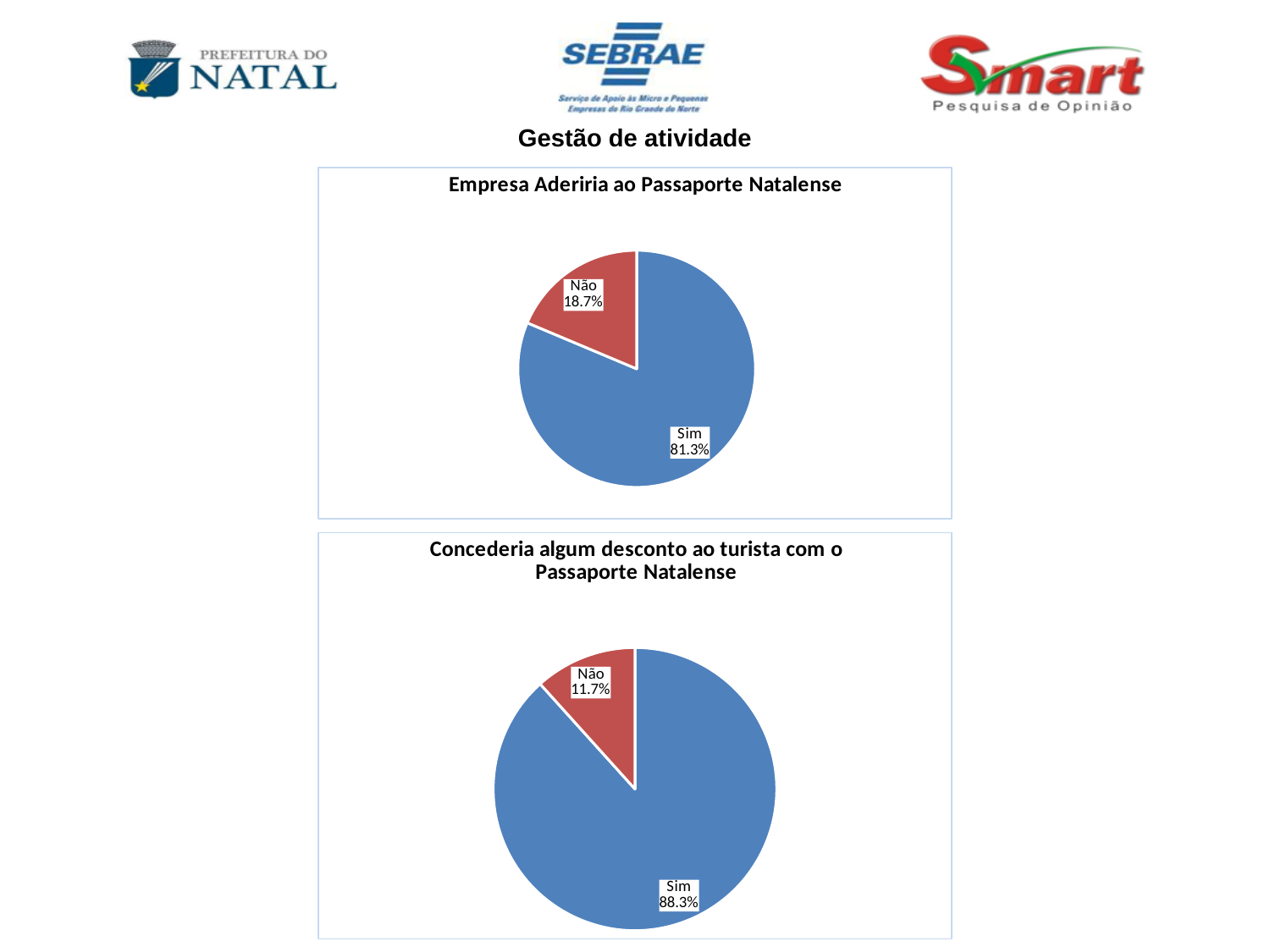
Which chart has the larger Não share, the top chart or the bottom chart? the top chart In the chart titled "Empresa Aderiria ao Passaporte Natalense", what percentage answered Sim? 81.3% In the top chart, what is the difference in percentage points between Sim and Não? 62.6 In the top chart, which response has the largest share? Sim In the bottom chart, which response has the smallest share? Não How many slices does the top chart have? 2 In the chart titled "Concederia algum desconto ao turista com o Passaporte Natalense", what percentage answered Sim? 88.3% In the bottom chart, what is the difference in percentage points between Sim and Não? 76.6 In the chart titled "Concederia algum desconto ao turista com o Passaporte Natalense", what percentage answered Não? 11.7% In the chart titled "Empresa Aderiria ao Passaporte Natalense", what percentage answered Não? 18.7% What kind of chart is the bottom chart? pie chart In the bottom chart, what colour is the Sim slice? blue